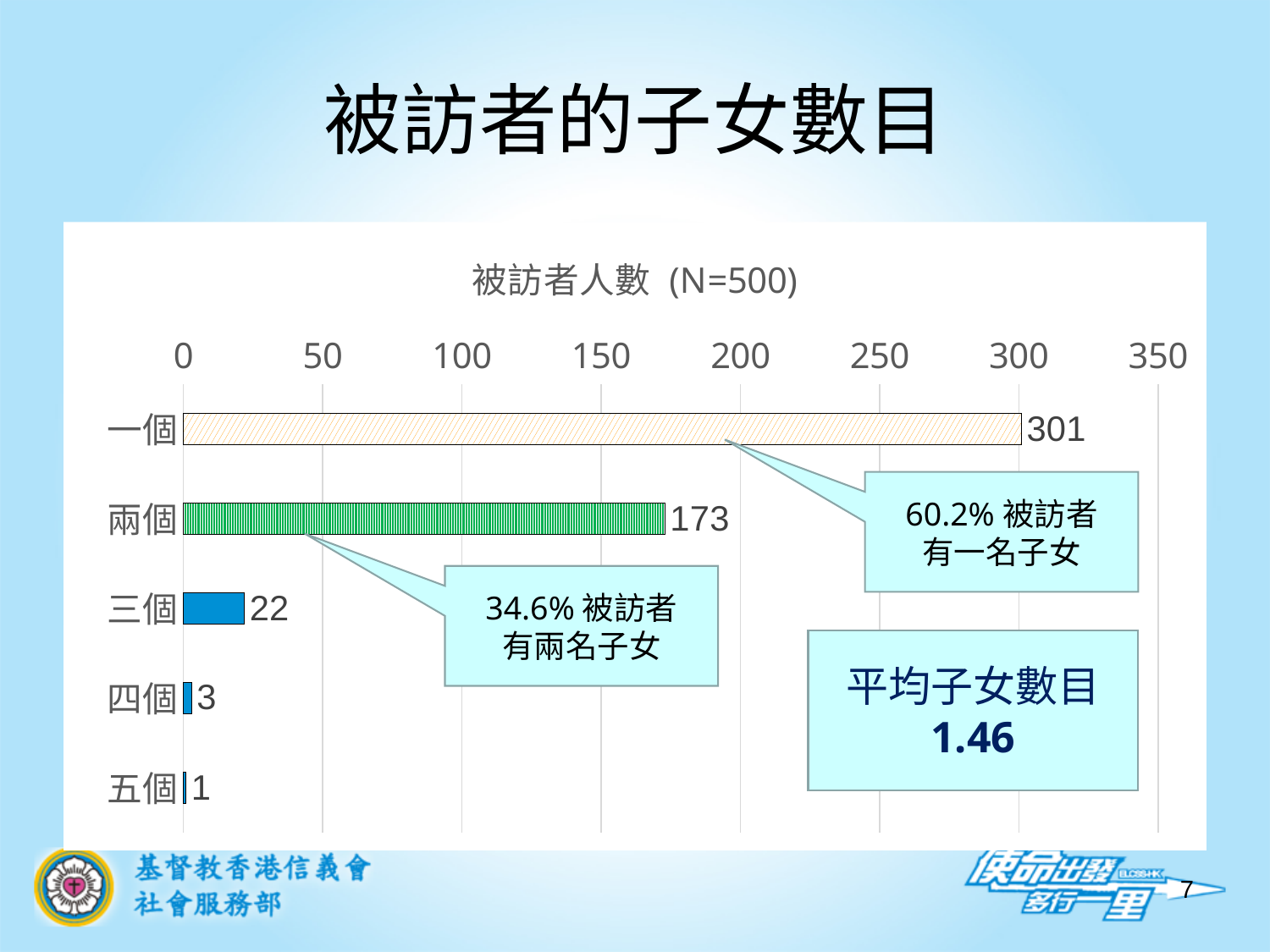
What is the value for 一個 (one child)? 301 Which is larger, the value for 三個 or the value for 四個? 三個 What is the value for 兩個 (two children)? 173 Is the value for 一個 greater or less than 300? greater What is the value for 三個 (three children)? 22 How many categories are shown in the chart? 5 Which category has the highest value? 一個 What is the difference between the values for 一個 and 兩個? 128 What is the title of the chart? 被訪者人數 (N=500) What kind of chart is shown on the slide? bar chart What is the value for 五個 (five children)? 1 Which category has the lowest value? 五個